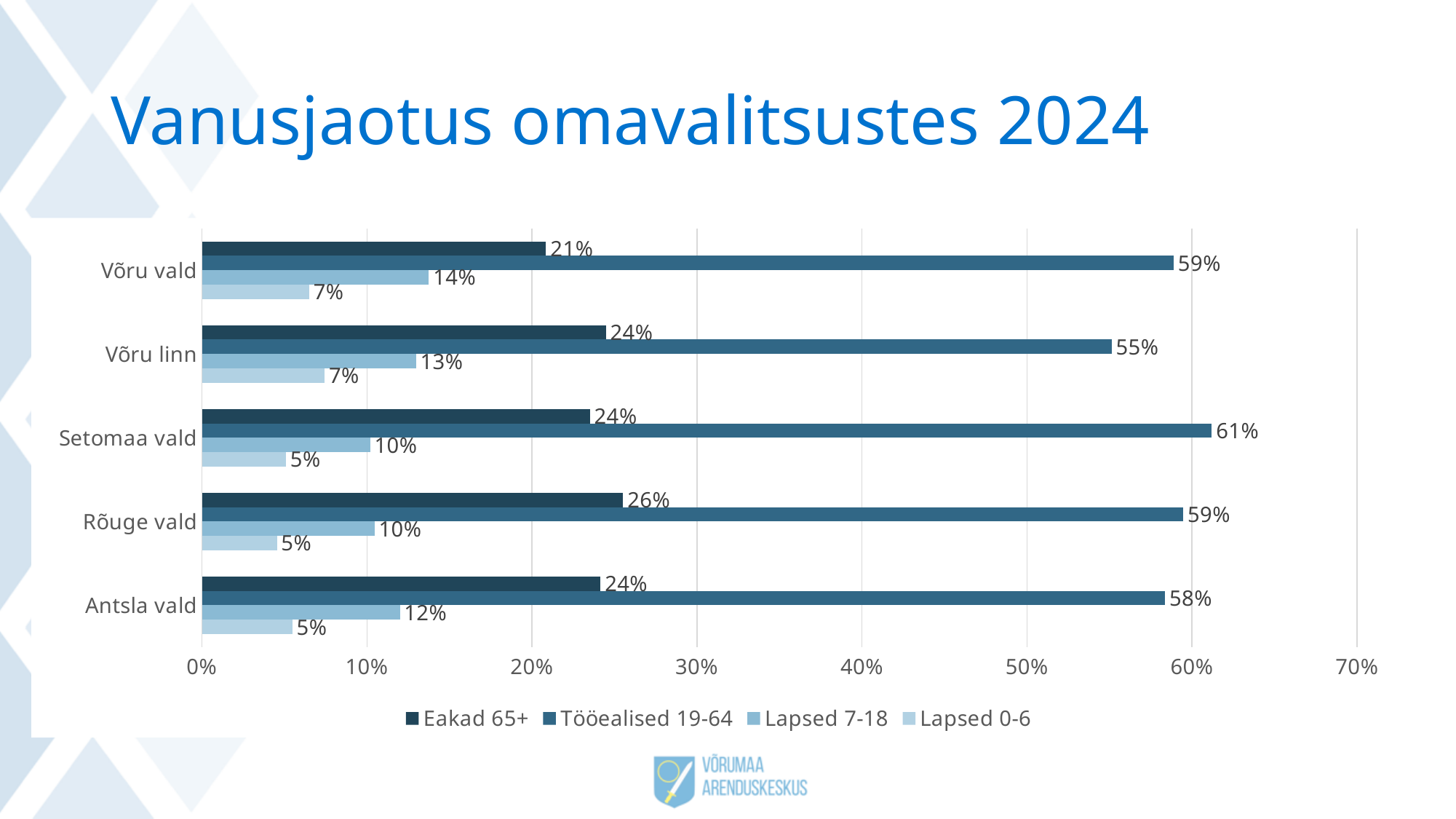
Which is larger: Lapsed 7-18 in Võru linn or Lapsed 7-18 in Rõuge vald? Võru linn How many municipalities are shown on the chart? 5 What is the value for Eakad 65+ in Rõuge vald? 26% What is the value for Lapsed 7-18 in Võru vald? 14% What type of chart is shown on the slide? Bar chart How many series does the legend list? 4 What is the value for Lapsed 0-6 in Antsla vald? 5% What is the difference between the Tööealised 19-64 values for Setomaa vald and Võru linn? 6% Which municipality has the lowest value for Eakad 65+? Võru vald What is the value for Tööealised 19-64 in Võru linn? 55% Which municipality has the lowest value for Tööealised 19-64? Võru linn Which municipality has the highest value for Tööealised 19-64? Setomaa vald